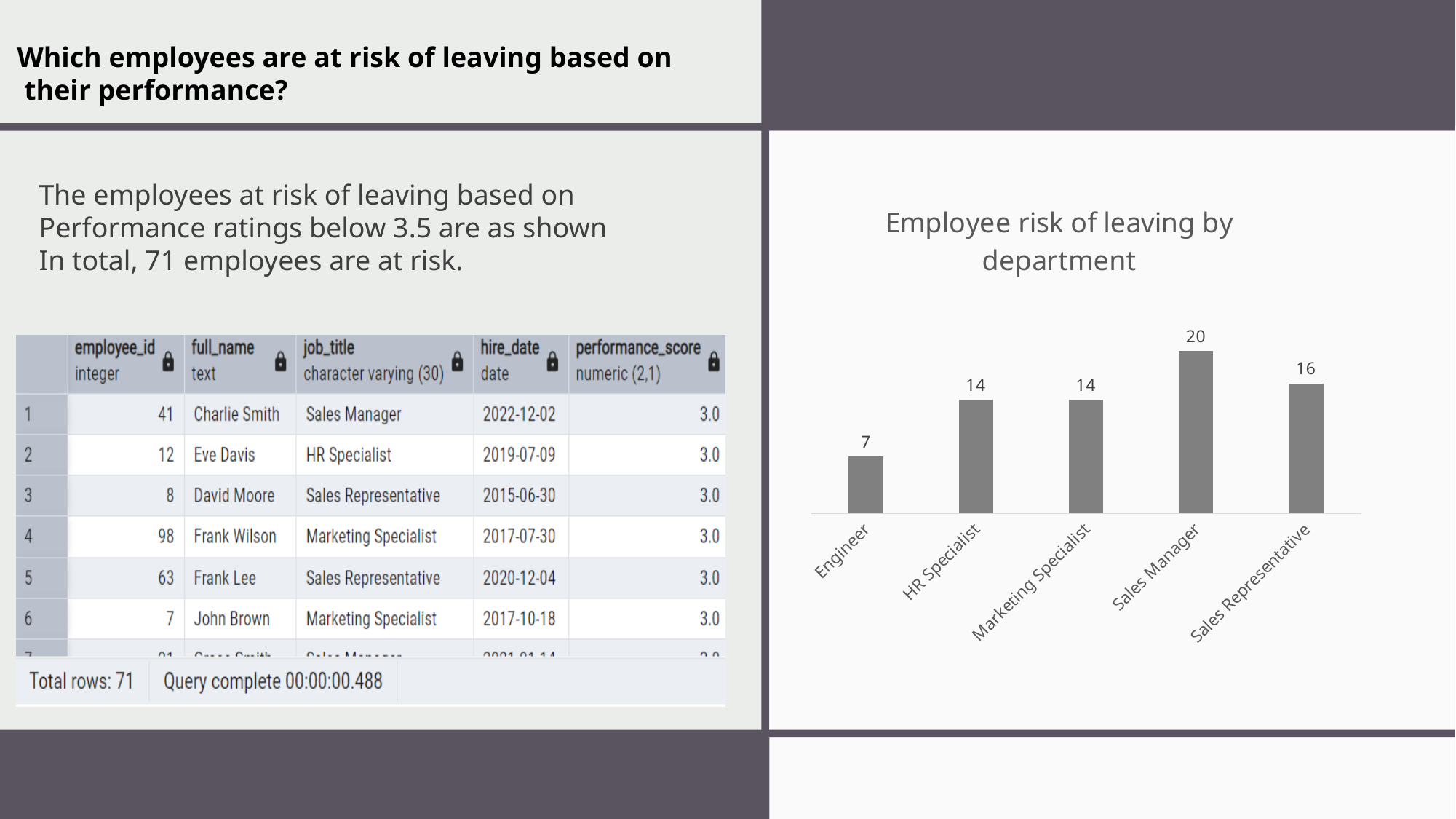
What is the difference between the values for Sales Manager and Engineer? 13 Which department has the lowest value in the chart? Engineer Which department has the highest value in the chart? Sales Manager What is the value for Engineer in the chart? 7 What is the difference between the values for Sales Representative and Marketing Specialist? 2 What is the value for HR Specialist in the chart? 14 What is the value for Sales Representative in the chart? 16 What is the title of the chart? Employee risk of leaving by department What is the value for Sales Manager in the chart? 20 How many departments are shown in the chart? 5 What kind of chart is shown on the slide? Bar chart Which is larger, the value for Sales Representative or the value for HR Specialist? Sales Representative